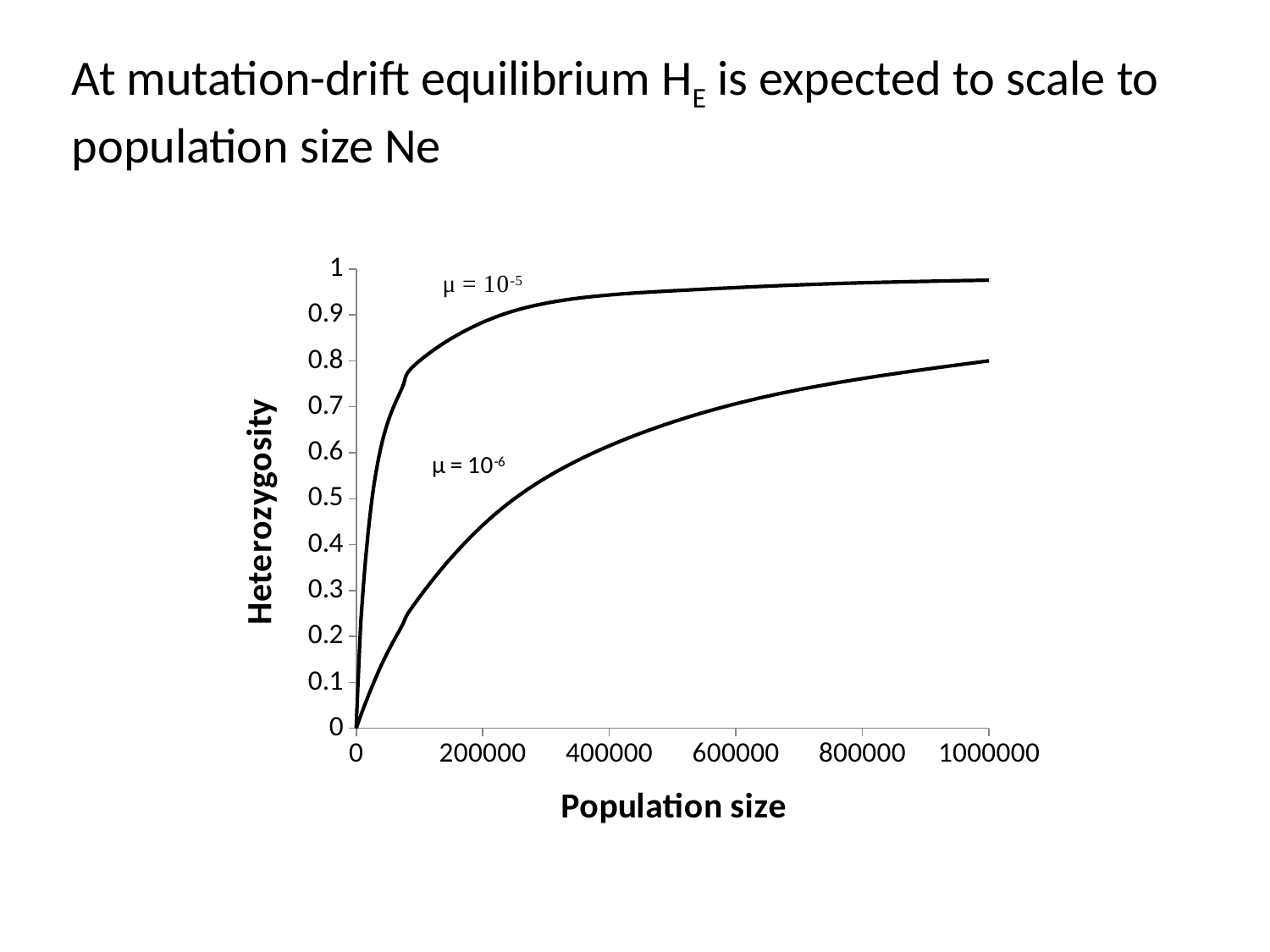
What is the label of the x axis? Population size What kind of chart is shown on the slide? line chart Which curve is higher at a population size of 600000, μ = 10^-5 or μ = 10^-6? μ = 10^-5 Is the heterozygosity for the μ = 10^-5 curve at a population size of 1000000 greater or less than 0.9? greater Is the heterozygosity for the μ = 10^-6 curve at a population size of 200000 greater or less than 0.3? greater What is the label of the y axis? Heterozygosity Is the heterozygosity for the μ = 10^-6 curve at a population size of 400000 greater or less than 0.7? less How many curves are plotted on the chart? 2 Does heterozygosity rise or fall as population size increases along the x axis? rise